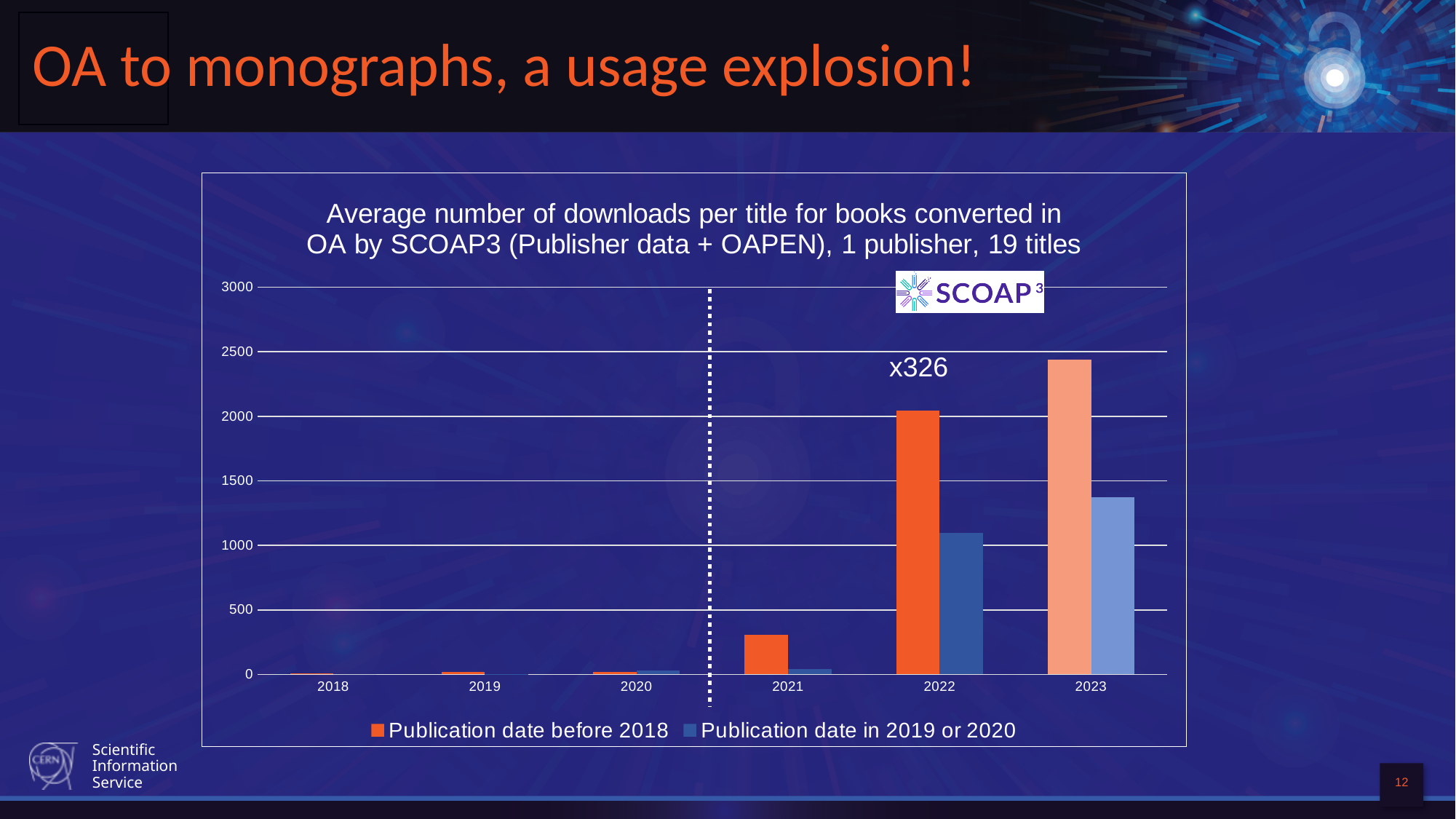
In which year is the value for 'Publication date in 2019 or 2020' highest? 2023 Is the value for 'Publication date in 2019 or 2020' in 2022 greater or less than 1000? greater Is the value for 'Publication date before 2018' in 2023 greater or less than 2500? less Is the value for 'Publication date before 2018' in 2021 greater or less than 500? less How many years are shown on the x axis of the chart? 6 In 2023, which series has the larger value: 'Publication date before 2018' or 'Publication date in 2019 or 2020'? Publication date before 2018 What kind of chart is shown on the slide? bar chart How many series does the chart's legend list? 2 What multiplier annotation is printed above the 2022 bars in the chart? x326 In which year is the value for 'Publication date before 2018' highest? 2023 Do the values for 'Publication date before 2018' rise or fall from 2021 to 2023? rise